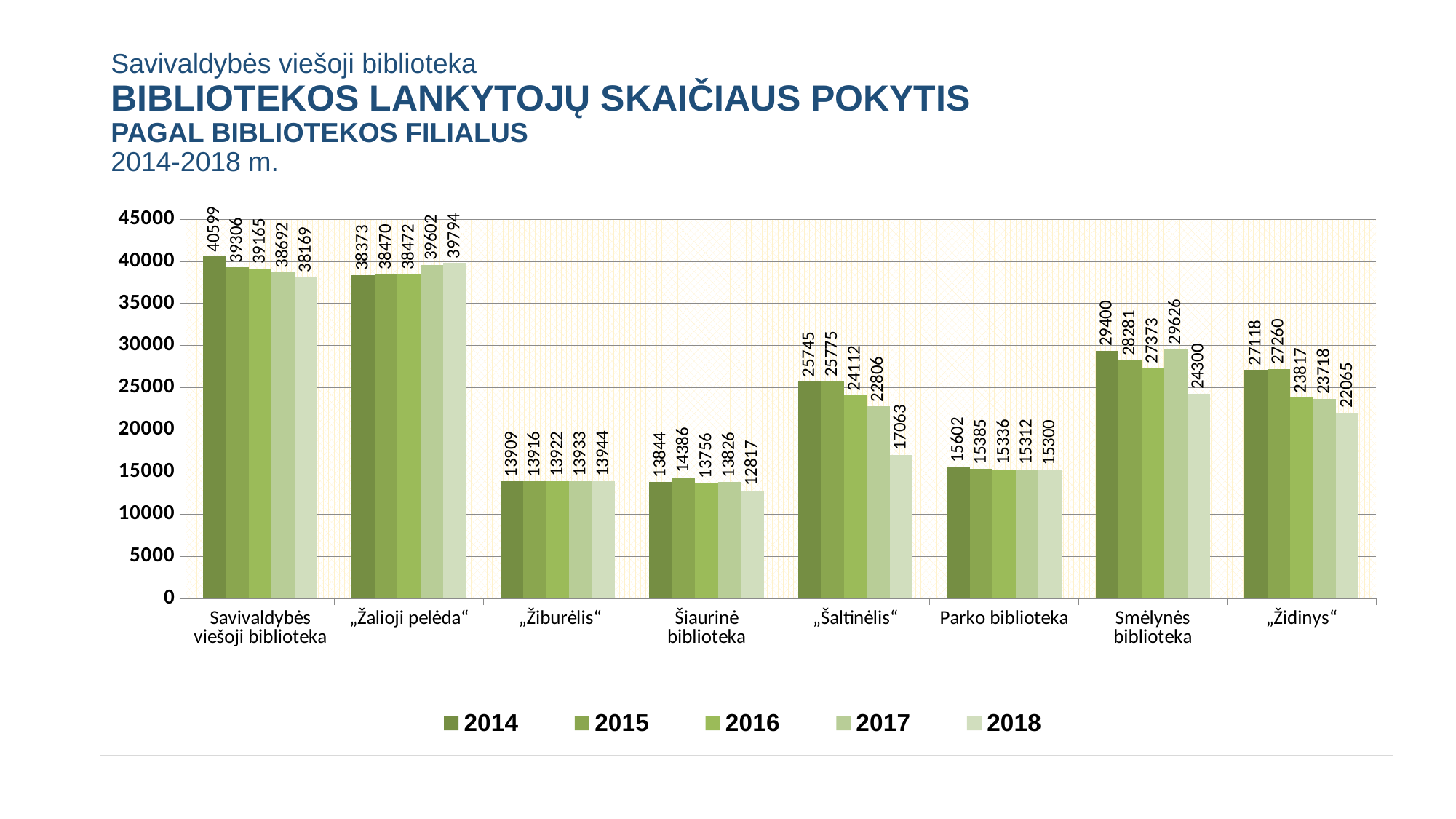
What was the number of visitors for „Šaltinėlis“ in 2018? 17063 Do the values for „Žiburėlis“ rise or fall from 2014 to 2018? rise Which library had the highest value in 2014? Savivaldybės viešoji biblioteka Which library had the lowest value in 2018? Šiaurinė biblioteka What was the value for Smėlynės biblioteka in 2017? 29626 What is the difference between the 2014 and 2018 values for „Šaltinėlis“? 8682 How many libraries (categories) are shown on the x axis? 8 How many series does the legend list? 5 Which is larger: the 2018 value for „Žalioji pelėda“ or the 2018 value for Savivaldybės viešoji biblioteka? „Žalioji pelėda“ What kind of chart is shown on the slide? bar chart What was the value for „Žalioji pelėda“ in 2014? 38373 Is the 2016 value for Smėlynės biblioteka greater or less than 25000? greater